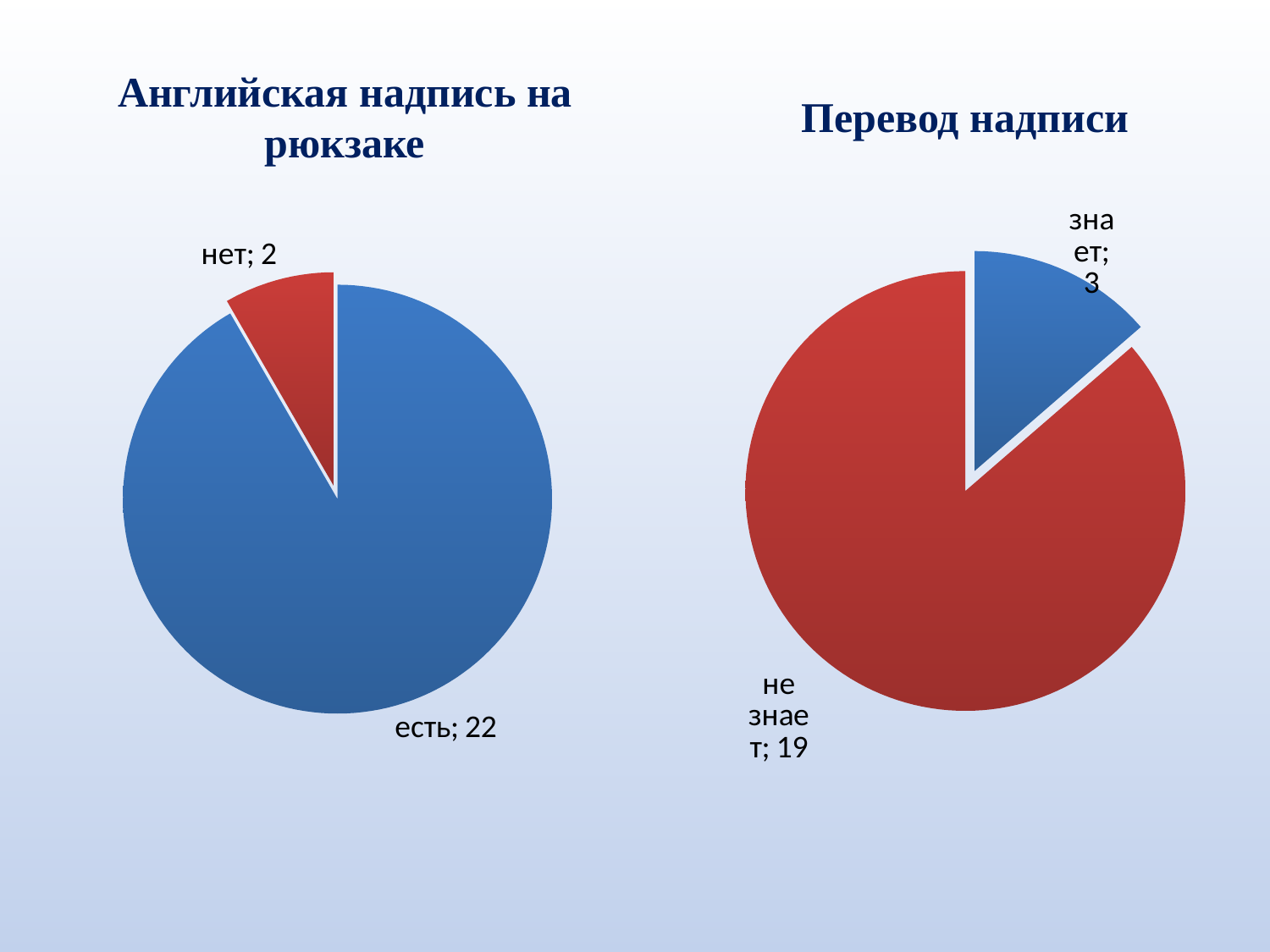
In the chart titled "Английская надпись на рюкзаке", which category has the largest slice? есть In the chart titled "Английская надпись на рюкзаке", what is the value for "есть"? 22 In the chart titled "Перевод надписи", what is the value for "знает"? 3 How many slices does the chart titled "Английская надпись на рюкзаке" have? 2 In the chart titled "Перевод надписи", what is the difference between the values for "не знает" and "знает"? 16 In the chart titled "Перевод надписи", which is larger: "знает" or "не знает"? не знает What kind of chart is the chart titled "Перевод надписи"? Pie chart In the chart titled "Перевод надписи", which category has the smallest slice? знает In the chart titled "Перевод надписи", what is the value for "не знает"? 19 In the chart titled "Английская надпись на рюкзаке", what is the value for "нет"? 2 In the chart titled "Английская надпись на рюкзаке", what is the difference between the values for "есть" and "нет"? 20 In the chart titled "Перевод надписи", what colour is the "не знает" slice? Red